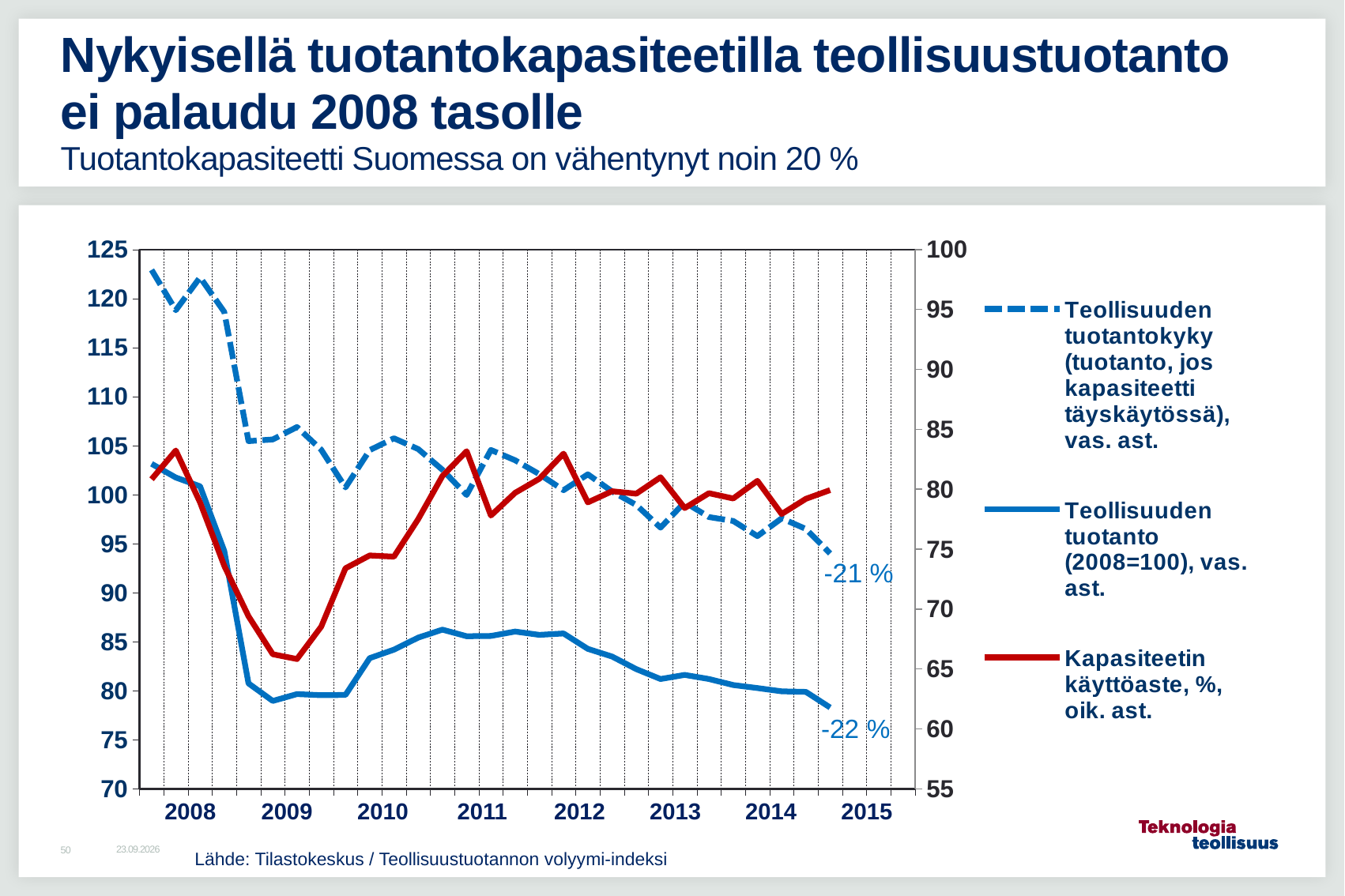
Is the Kapasiteetin käyttöaste value in early 2009 greater or less than 70 on the right axis? less What percentage change is annotated next to the end of the Teollisuuden tuotanto line? -22 % Which series is plotted against the right-hand axis? Kapasiteetin käyttöaste, % Is the value of Teollisuuden tuotanto in 2011 greater or less than 90? less How many series does the legend list? 3 What percentage change is annotated next to the end of the Teollisuuden tuotantokyky line? -21 % Is the value of Teollisuuden tuotantokyky at the start of 2008 greater or less than 120? greater What kind of chart is shown on the slide? line chart Does the Teollisuuden tuotantokyky series rise or fall from 2008 to 2015? fall In which year does the Kapasiteetin käyttöaste series reach its lowest point? 2009 In 2009, which is higher: Teollisuuden tuotantokyky or Teollisuuden tuotanto? Teollisuuden tuotantokyky